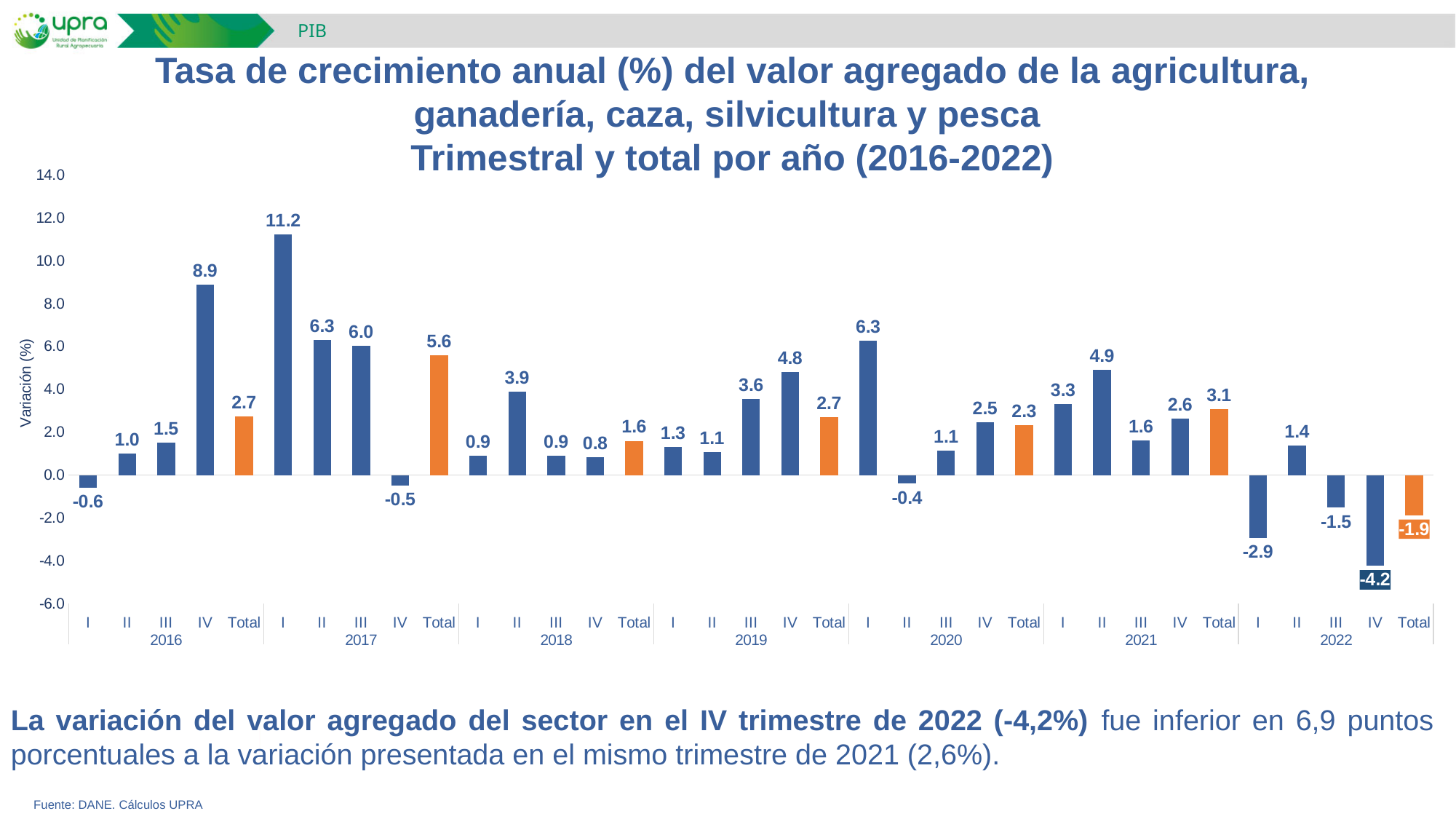
What is the value for quarter I of 2020? 6.3 Is the value for quarter IV of 2016 greater or less than 8.0? greater What is the annual total growth rate shown for 2017? 5.6 What is the difference between the value for quarter IV of 2021 and quarter IV of 2022? 6.8 Which bar has the highest value in the chart? I 2017 (11.2) Which is larger: the annual total for 2021 or the annual total for 2020? 2021 (3.1) Do the quarterly values for 2017 rise or fall from quarter I to quarter IV? fall What is the value for quarter IV of 2022? -4.2 Which bar has the lowest value in the chart? IV 2022 (-4.2) What type of chart is shown on the slide? bar chart What colour are the bars for the annual totals? orange How many years are covered on the x axis of the chart? 7